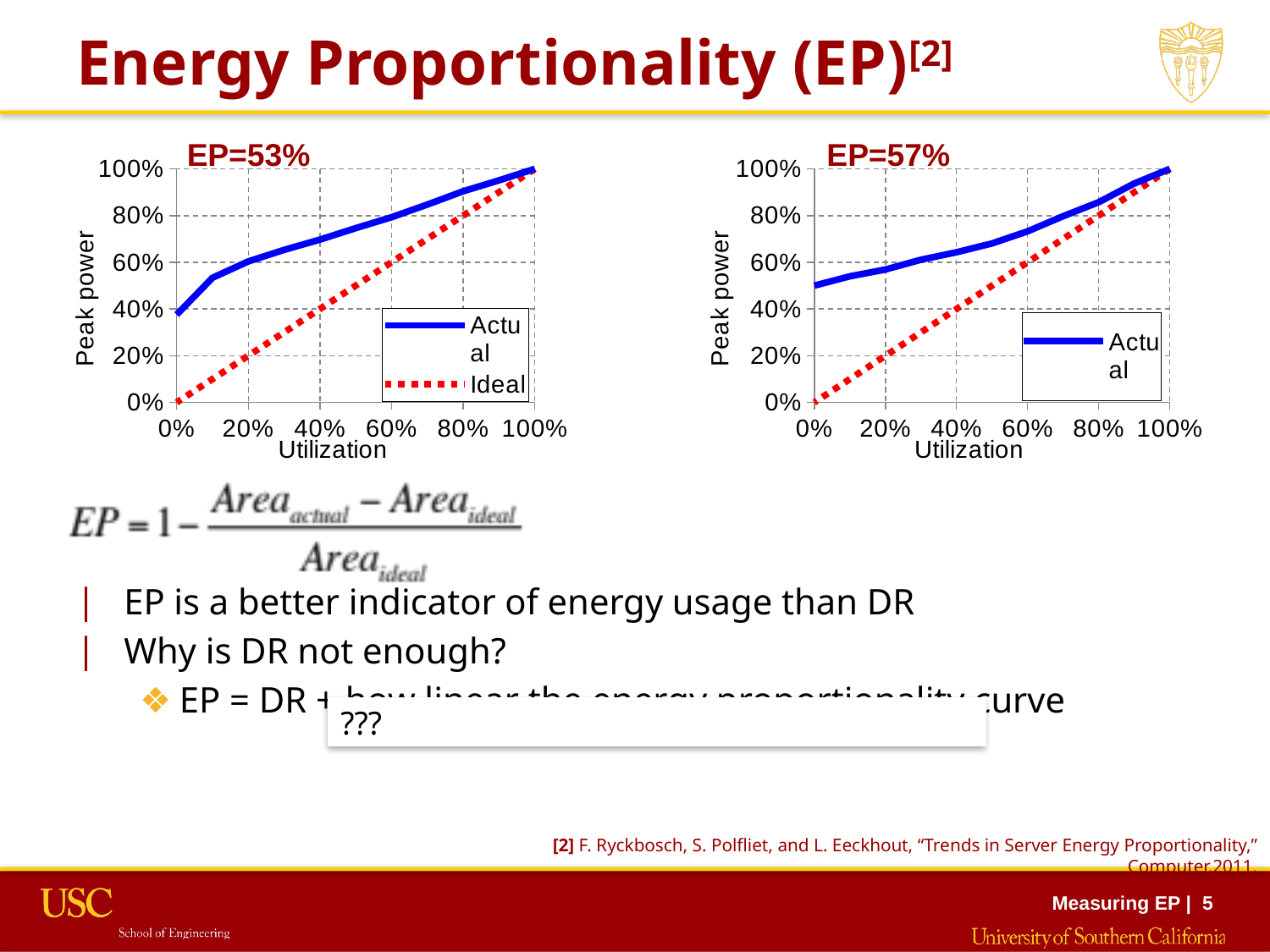
In the right chart (EP=57%), does the Actual peak power rise or fall as utilization increases? rise In the right chart (EP=57%), what is the Actual peak power at 0% utilization: greater or less than 40%? greater In the left chart (EP=53%), what is the Ideal peak power at 100% utilization? 100% What is the label on the y axis of the left chart? Peak power In the left chart (EP=53%), is the Actual peak power at 0% utilization greater or less than 20%? greater What kind of chart is the left chart labelled EP=53%? line chart What EP value is printed above the right chart? EP=57% In the right chart (EP=57%), is the Actual peak power at 0% utilization greater or less than 60%? less In the right chart (EP=57%), how many series does the legend list? 1 In the left chart (EP=53%), at 20% utilization, which series has the higher peak power, Actual or Ideal? Actual In the left chart (EP=53%), how many series does the legend list? 2